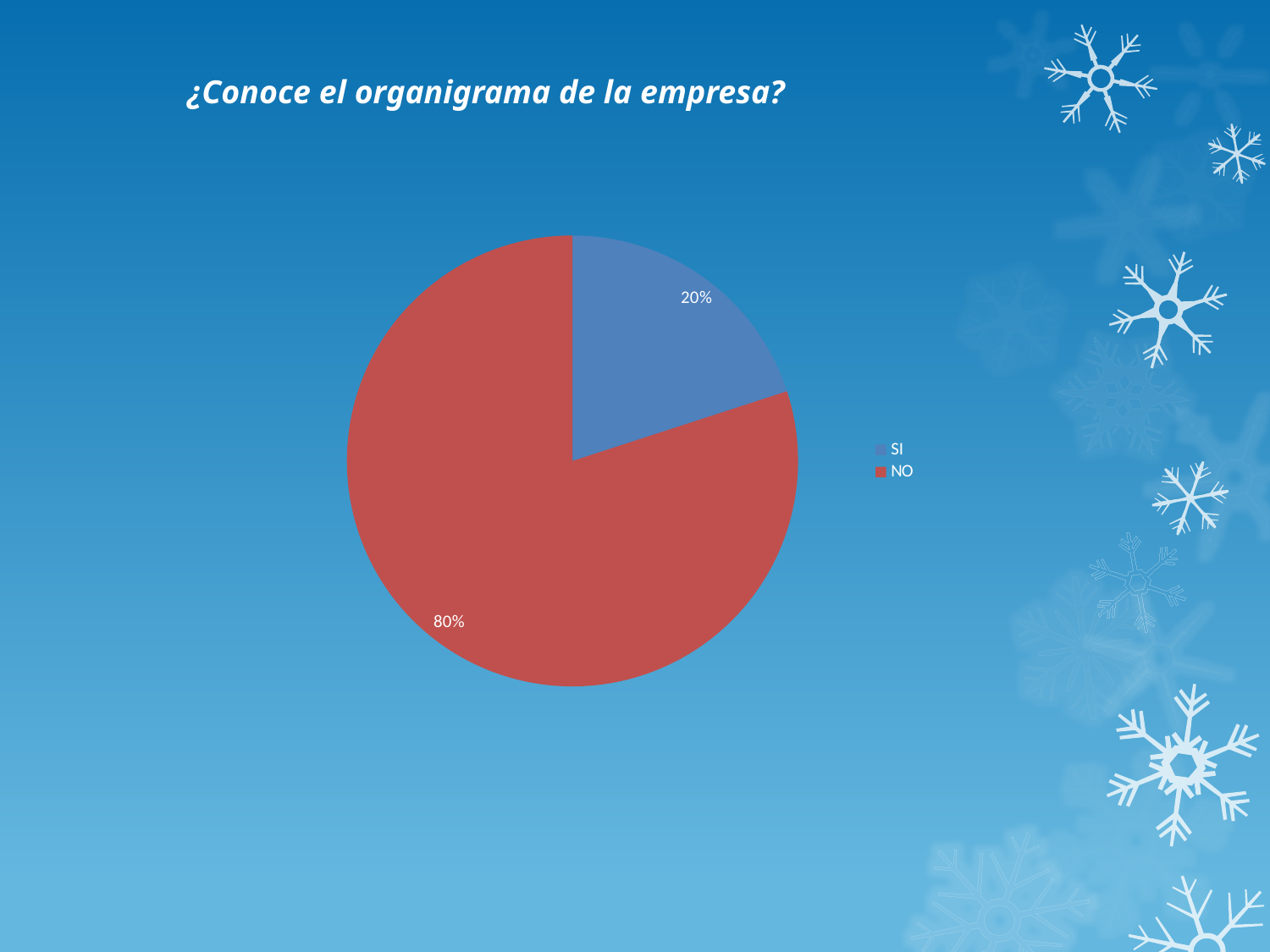
What is the title of the slide above the chart? ¿Conoce el organigrama de la empresa? What percentage of the pie is labelled for NO? 80% Which category has the largest share of the pie? NO What is the difference in percentage points between the NO and SI slices? 60 Which slice is larger, SI or NO? NO Which category has the smallest share of the pie? SI What share of the pie does the SI slice represent? 20% What kind of chart is shown on the slide? pie chart How many entries does the legend list? 2 What colour is the NO slice in the pie chart? red What percentage of the pie is labelled for SI? 20% How many slices does the pie chart have? 2